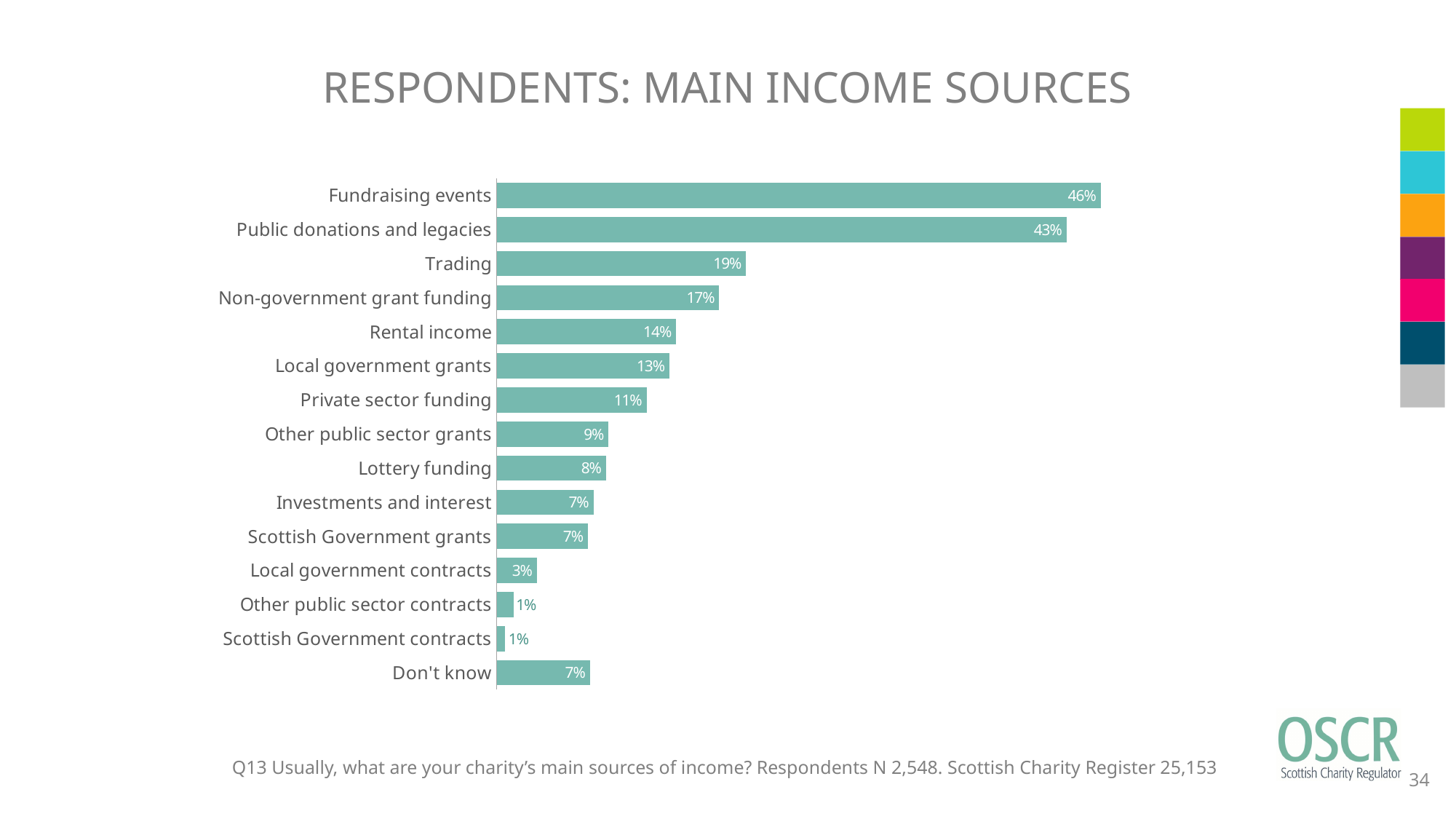
What percentage of respondents cited Fundraising events as a main income source? 46% What is the value shown for Trading? 19% Which is larger, the value for Non-government grant funding or the value for Private sector funding? Non-government grant funding What is the difference between the values for Fundraising events and Public donations and legacies? 3% What is the difference between the values for Trading and Rental income? 5% Which is larger, the value for Lottery funding or the value for Local government contracts? Lottery funding What is the title of the chart on the slide? RESPONDENTS: MAIN INCOME SOURCES What is the value for Don't know? 7% Which income source has the highest percentage of respondents? Fundraising events What percentage is shown for Local government grants? 13% What kind of chart is shown on the slide? Bar chart How many income source categories are shown in the chart? 15